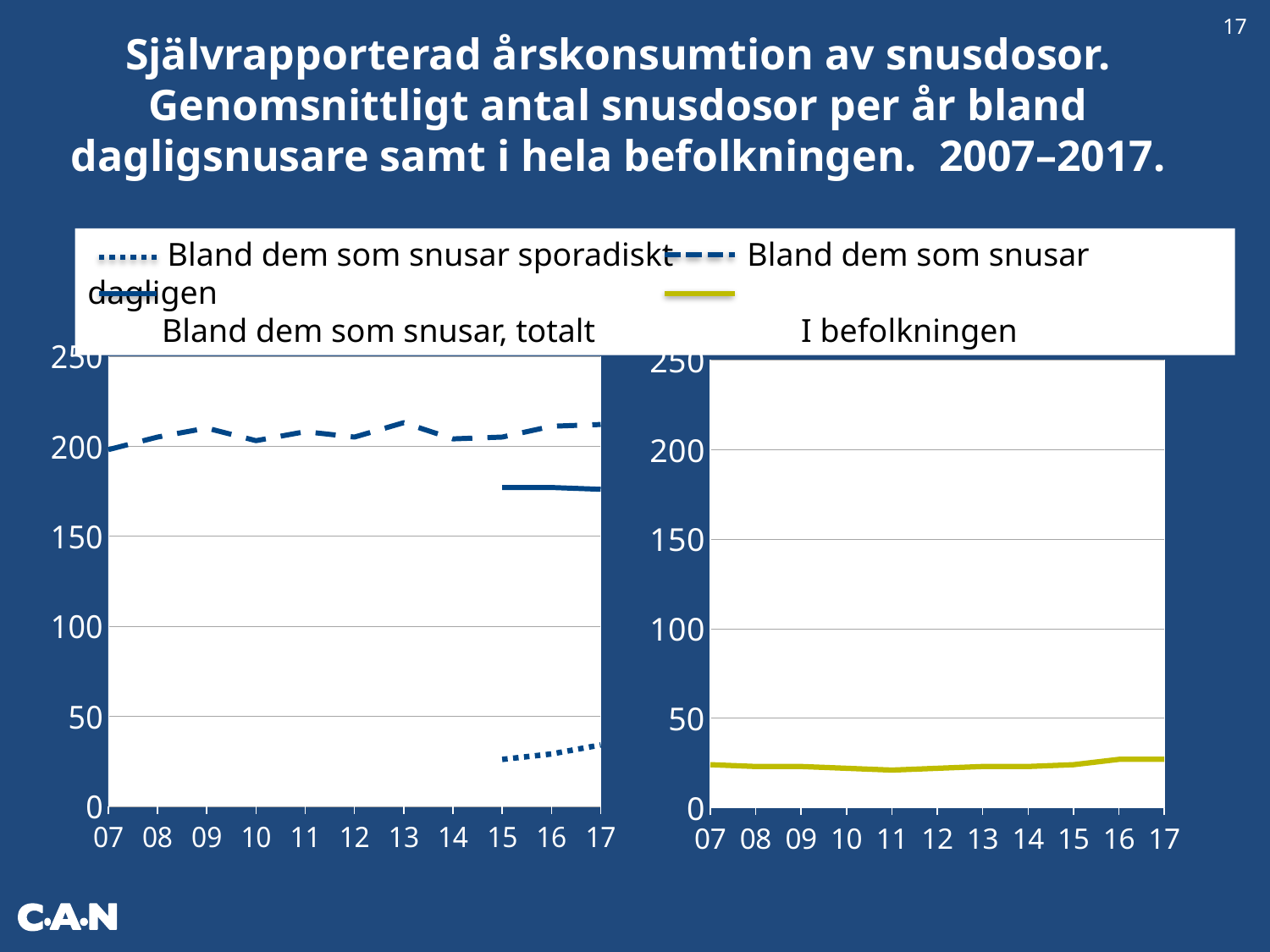
In the left chart, does the value for 'Bland dem som snusar dagligen' rise or fall from 07 to 09? rise In the left chart, is the value for 'Bland dem som snusar dagligen' in 13 greater or less than 250? less How many series does the legend list? 4 In the right chart (I befolkningen), is the value in 17 greater or less than 50? less What kind of chart is used on this slide? line chart In the left chart, is the value for 'Bland dem som snusar sporadiskt' in 17 greater or less than 50? less In the left chart (Bland dem som snusar, totalt), how many years are shown on the x axis? 11 Which series is drawn in yellow? I befolkningen In the left chart, which series has the higher value in 17: 'Bland dem som snusar dagligen' or 'Bland dem som snusar sporadiskt'? Bland dem som snusar dagligen In the left chart, which series has the highest value in 15? Bland dem som snusar dagligen